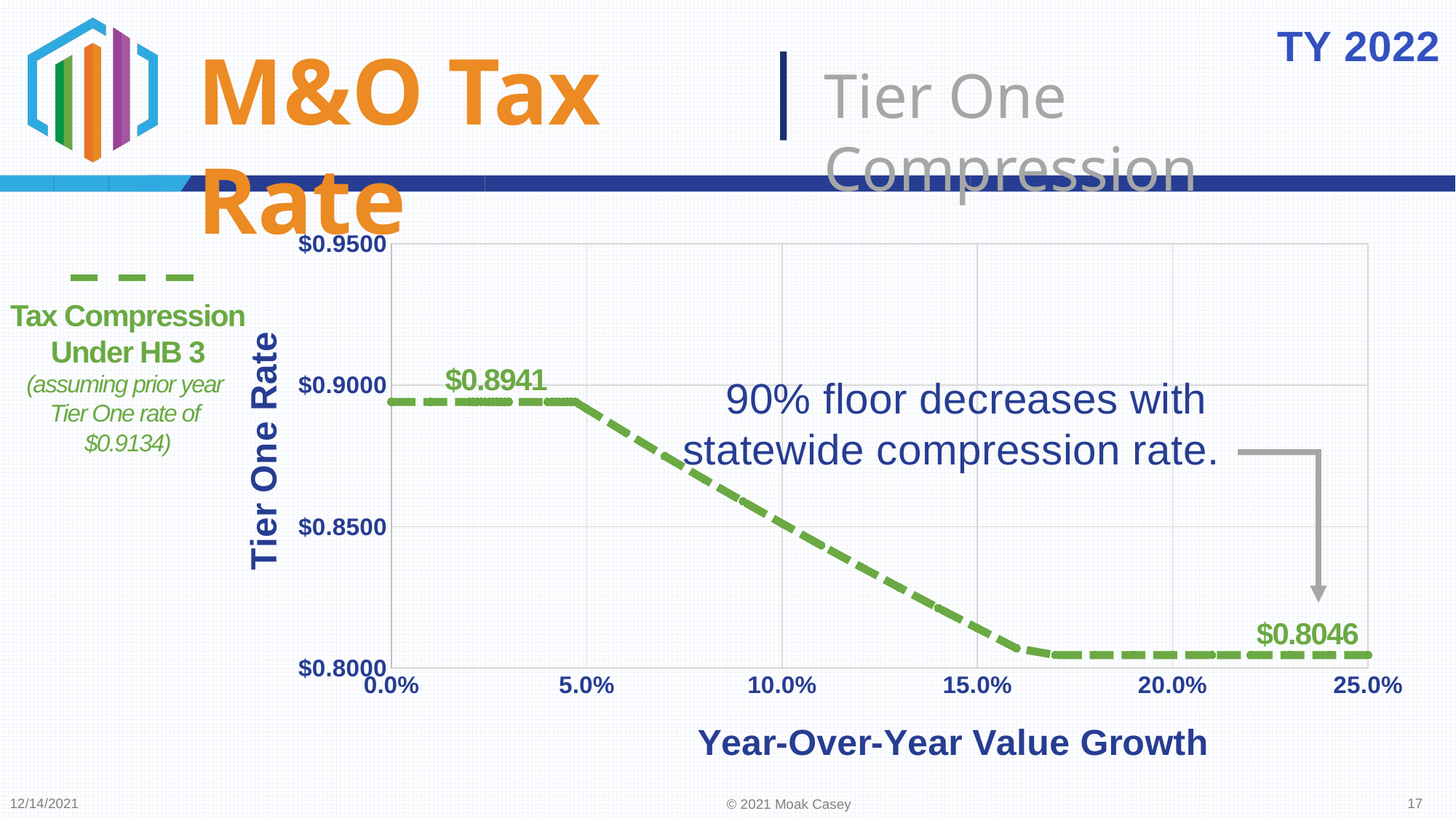
What is the lowest Tier One Rate shown on the line? $0.8046 Is the Tier One Rate at 5.0% year-over-year value growth greater or less than $0.8500? greater What is the Tier One Rate at 25.0% year-over-year value growth? $0.8046 What is the difference between the Tier One Rate at 0.0% growth and at 25.0% growth? $0.0895 What is the highest Tier One Rate shown on the line? $0.8941 Which is larger: the Tier One Rate at 0.0% growth or at 25.0% growth? 0.0% growth What kind of chart is shown on the slide? line chart Does the Tier One Rate rise or fall as year-over-year value growth increases? fall How many series does the chart legend list? 1 What is the Tier One Rate at 0.0% year-over-year value growth? $0.8941 What is the title of the chart's x axis? Year-Over-Year Value Growth Is the Tier One Rate at 15.0% year-over-year value growth greater or less than $0.8500? less